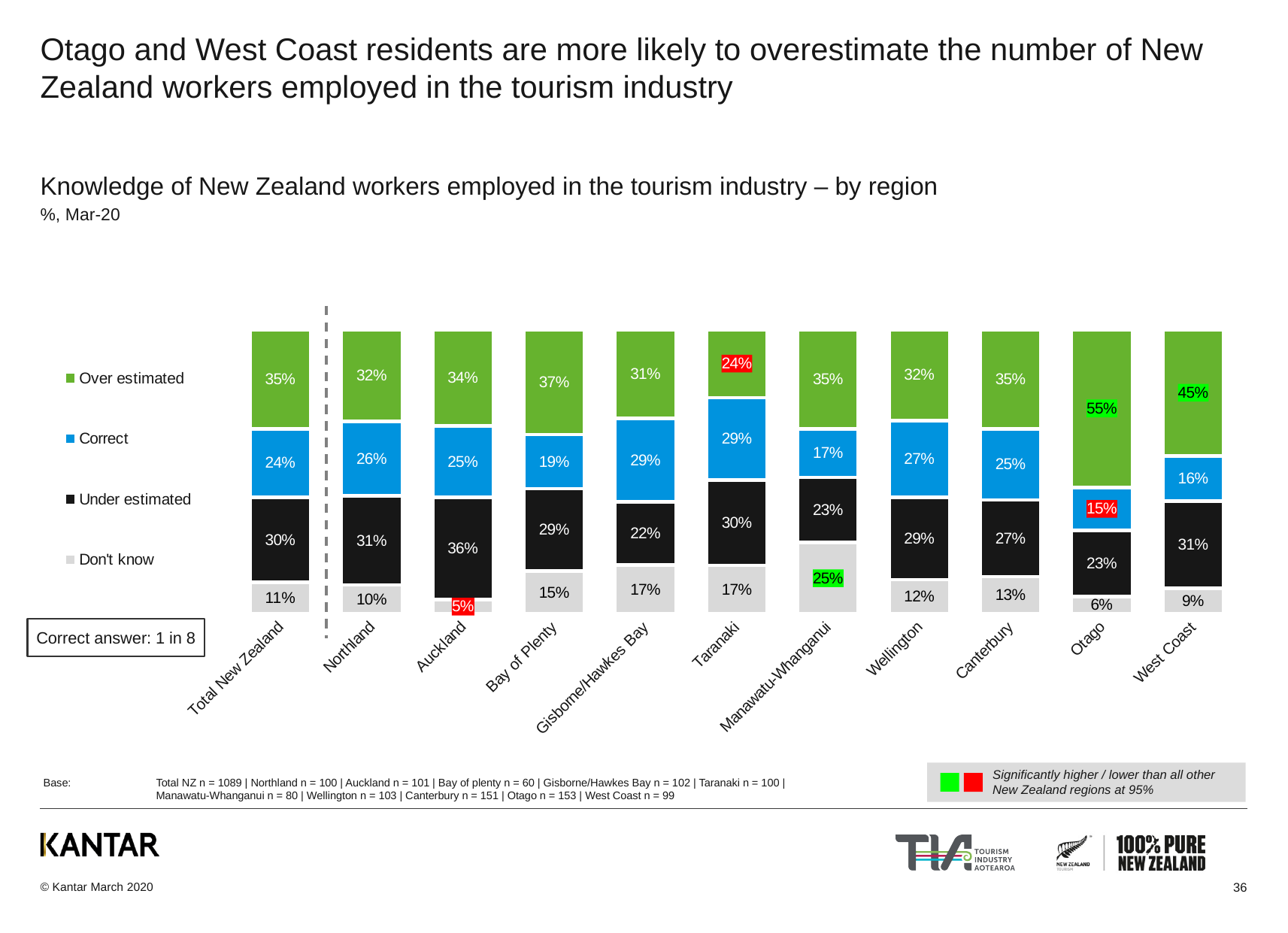
What is the 'Over estimated' value for Otago? 55% What kind of chart is shown on the slide? Stacked bar chart What is the difference between the 'Over estimated' values for Otago and West Coast? 10% How many series does the legend list? 4 What is the 'Don't know' value for Manawatu-Whanganui? 25% Which region has the lowest 'Don't know' value? Auckland Which region has the highest 'Over estimated' value? Otago Which is larger: the 'Under estimated' value for Auckland or for Gisborne/Hawkes Bay? Auckland What is the 'Correct' value for Total New Zealand? 24% What is the 'Under estimated' value for Taranaki? 30% What correct answer is stated in the box on the slide? 1 in 8 How many regions (including Total New Zealand) are plotted on the chart? 11